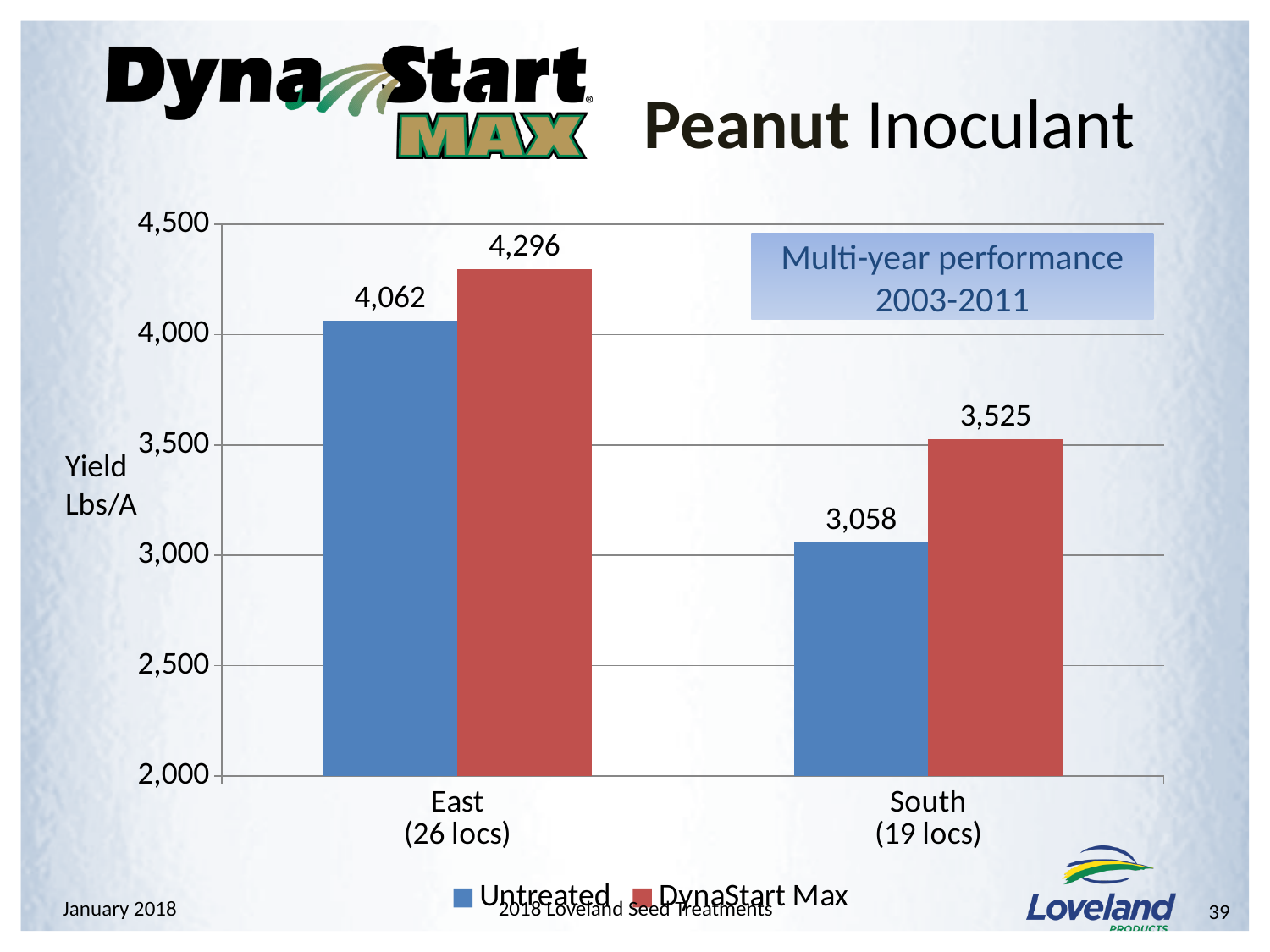
What is the yield for Untreated in the South (19 locs) category? 3,058 What is the difference between the DynaStart Max and Untreated yields in the East (26 locs) category? 234 What is the difference between the DynaStart Max and Untreated yields in the South (19 locs) category? 467 What is the yield for DynaStart Max in the East (26 locs) category? 4,296 What is the label on the y axis of the chart? Yield Lbs/A Which bar shows the highest yield on the chart? DynaStart Max, East (26 locs) What kind of chart is shown on the slide? Bar chart What is the yield for DynaStart Max in the South (19 locs) category? 3,525 Which is larger: the Untreated yield in the East or the DynaStart Max yield in the South? Untreated yield in the East What is the yield for Untreated in the East (26 locs) category? 4,062 Which bar shows the lowest yield on the chart? Untreated, South (19 locs) How many series does the legend list? 2